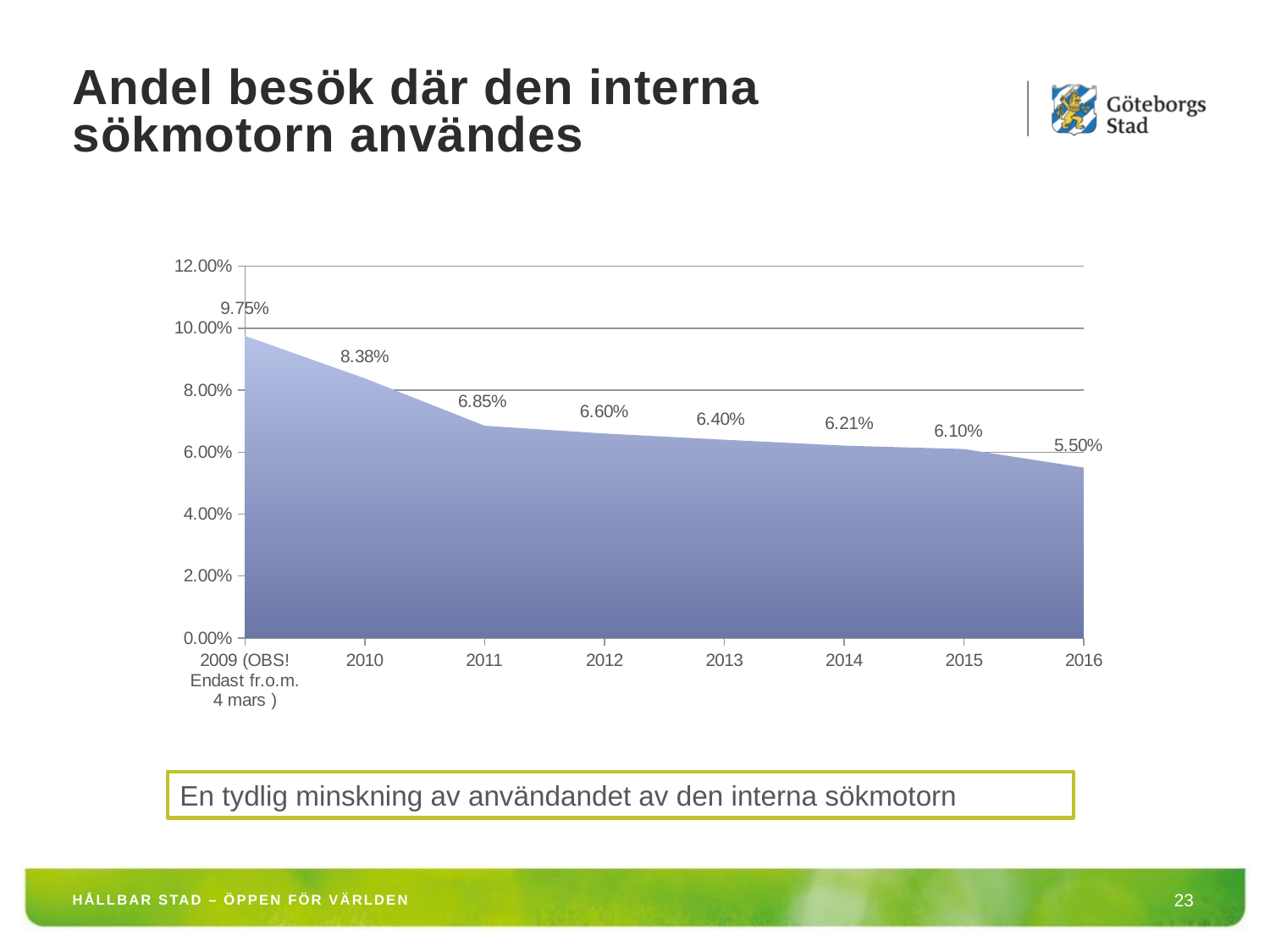
What is the value for 2010? 8.38% What is the value for 2013? 6.40% What kind of chart is this? area chart Which is larger, the value for 2012 or the value for 2015? 2012 Do the values rise or fall from 2009 to 2016? fall Is the value for 2014 greater or less than 8.00%? less What is the value for 2016? 5.50% Which year has the lowest value? 2016 What is the difference between the values for 2009 and 2016? 4.25% What is the difference between the values for 2010 and 2011? 1.53% Which year has the highest value? 2009 How many years are shown on the x axis? 8